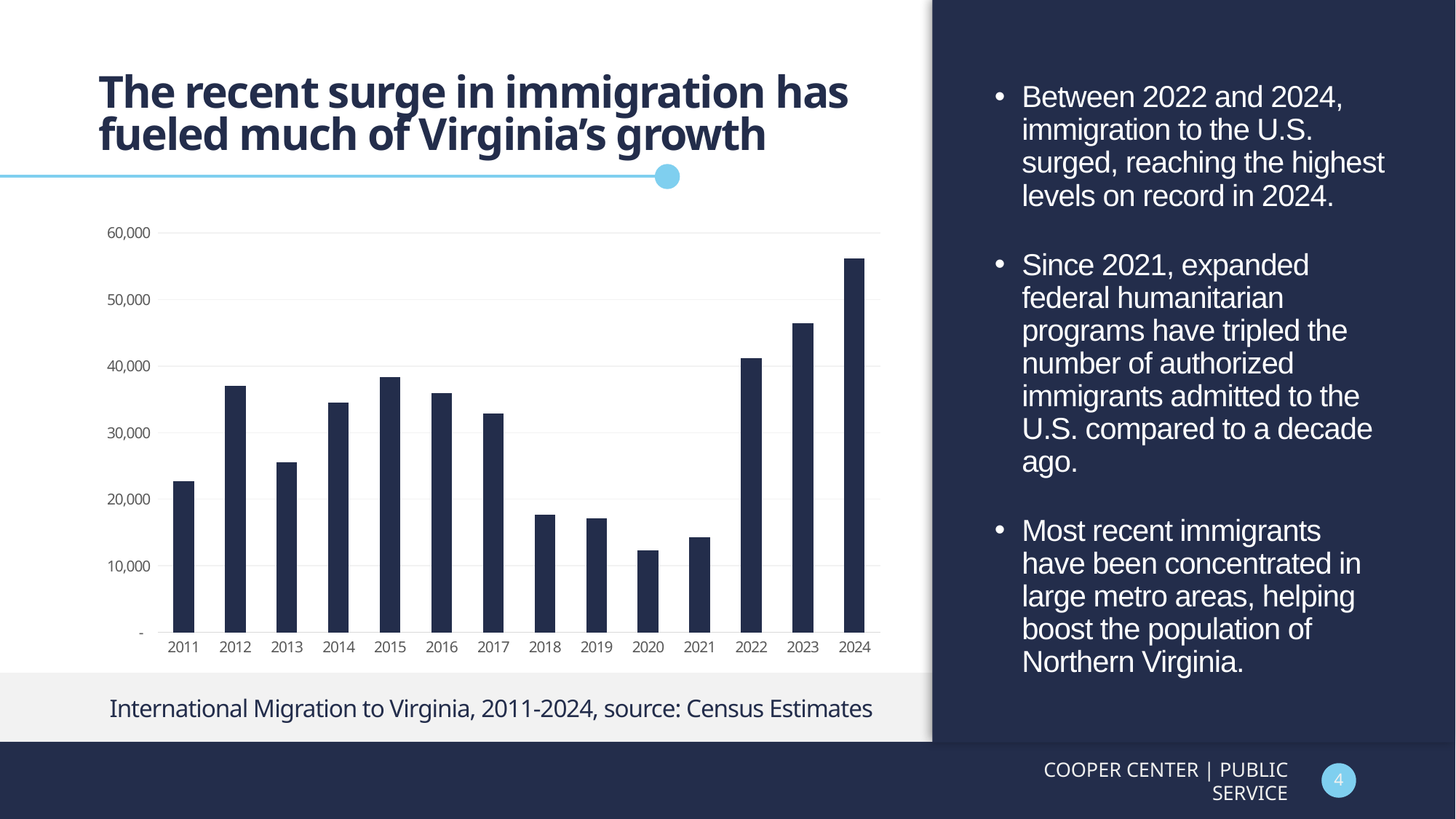
Is the value for 2024 greater or less than 50,000? greater Do the values rise or fall from 2022 to 2024? rise Which year has the larger value, 2022 or 2023? 2023 Which year has the highest international migration to Virginia? 2024 What kind of chart is shown on the slide? bar chart Is the value for 2020 greater or less than 10,000? greater Which year has the larger value, 2012 or 2013? 2012 Which year has the lowest international migration to Virginia? 2020 According to the caption, what is the source of the chart's data? Census Estimates How many years are plotted on the chart? 14 Is the value for 2023 greater or less than 40,000? greater